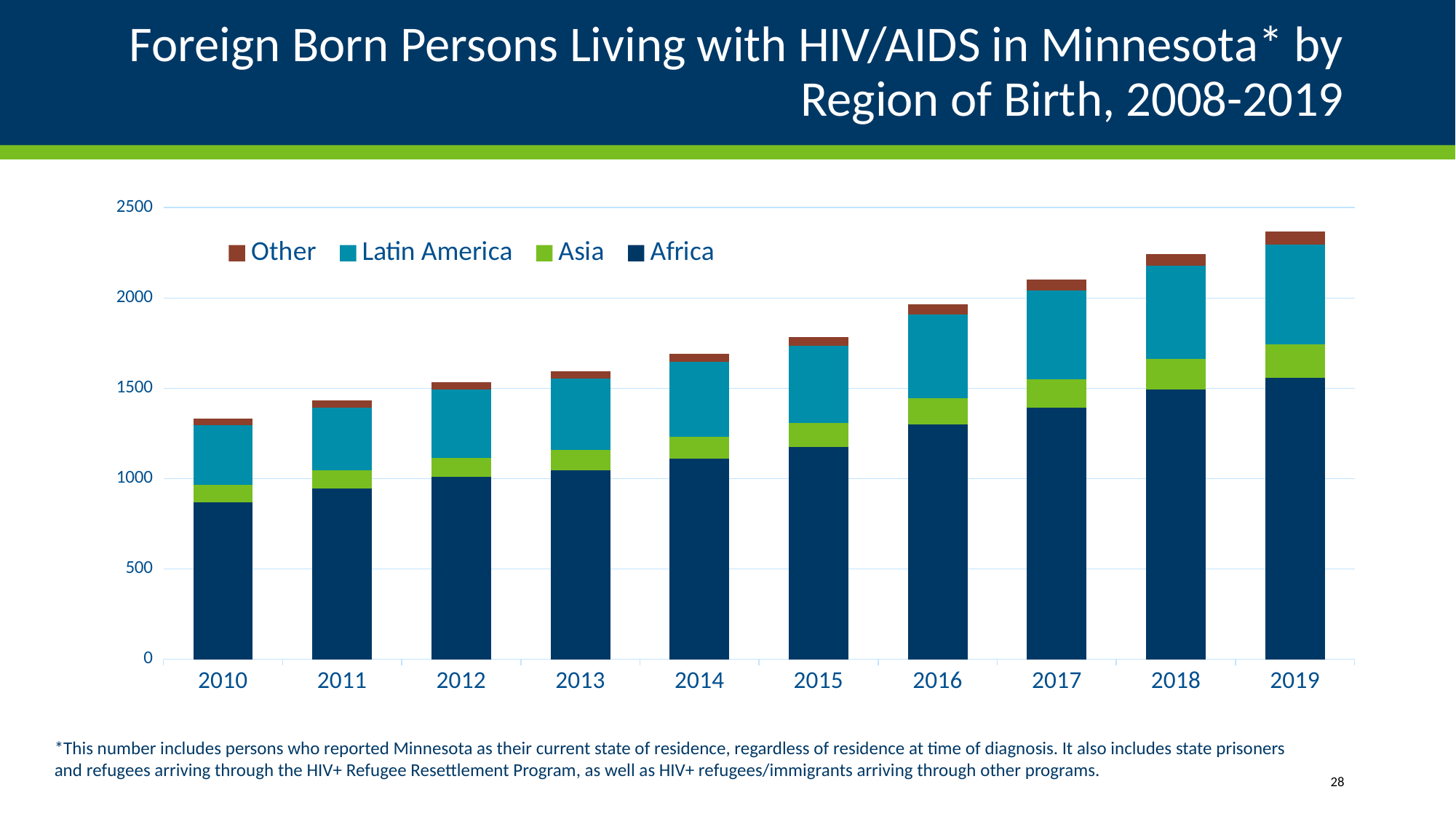
Do the total bar heights rise or fall from 2010 to 2019? rise Which region is the largest segment in every bar? Africa How many series does the legend list? 4 Is the total bar height for 2010 greater or less than 1500? less How many years are shown along the x axis? 10 What kind of chart is shown on the slide? stacked bar chart Which year has the tallest stacked bar? 2019 Is the Africa value for 2010 greater or less than 1000? less Is the total bar height for 2019 greater or less than 2000? greater Which region forms the bottom segment of each stacked bar? Africa Which year has the shortest stacked bar? 2010